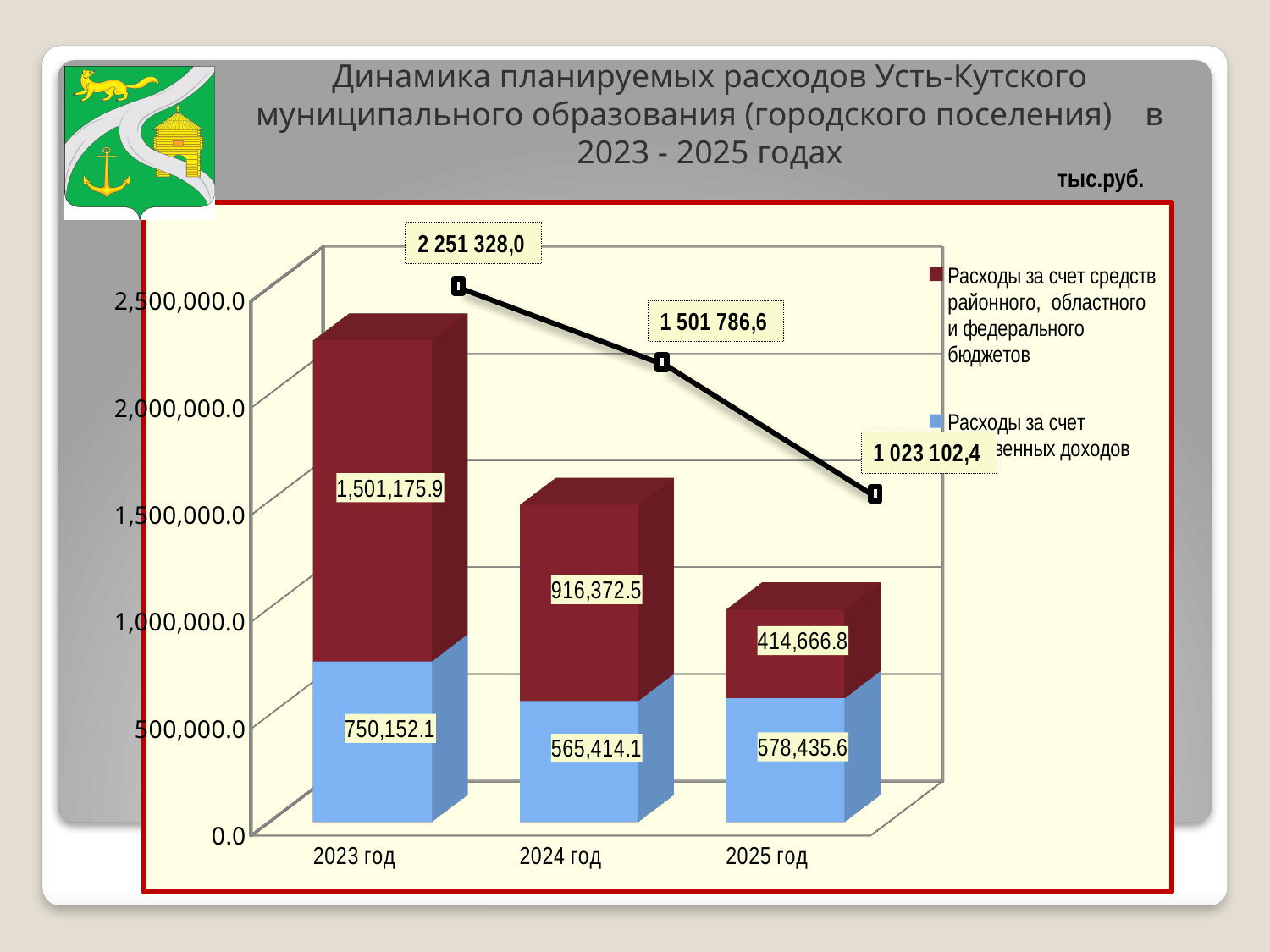
How many series does the legend list? 2 What type of chart is shown on the slide? Stacked bar chart with a line What is the difference between the dark red series values for 2023 год and 2024 год? 584,803.4 What is the value of the dark red series (Расходы за счет средств районного, областного и федерального бюджетов) for 2023 год? 1,501,175.9 How many year categories are shown on the x axis? 3 In which year is the dark red series (Расходы за счет средств районного, областного и федерального бюджетов) highest? 2023 год In which year is the blue series lowest? 2024 год What is the value of the dark red series for 2025 год? 414,666.8 What total value is labelled on the line for 2023 год? 2 251 328,0 What is the value of the blue series for 2024 год? 565,414.1 What total value is labelled on the line for 2025 год? 1 023 102,4 Does the line of total expenditures rise or fall from 2023 год to 2025 год? Falls